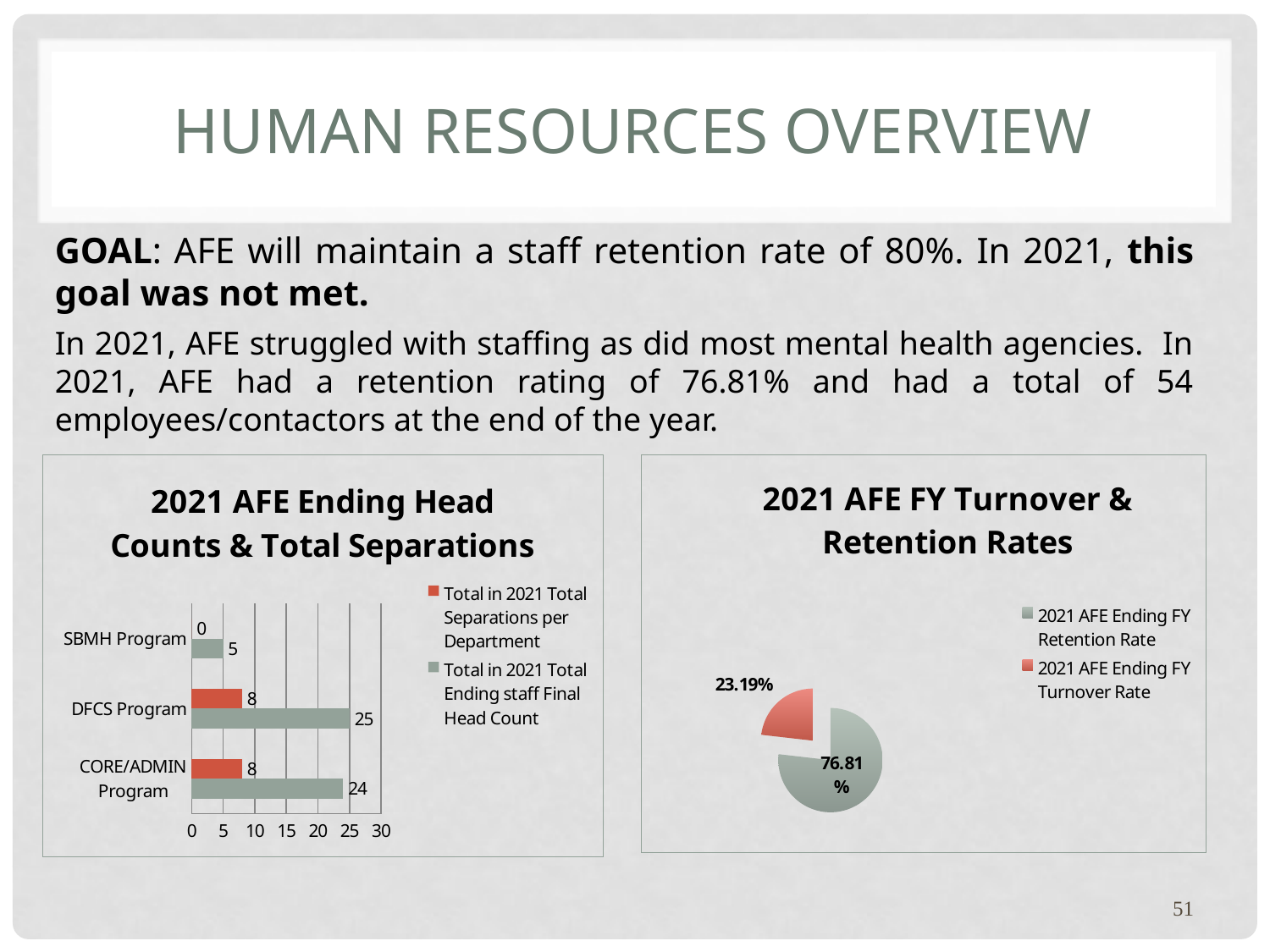
In the '2021 AFE Ending Head Counts & Total Separations' chart, what is the Total in 2021 Total Ending staff Final Head Count for the CORE/ADMIN Program? 24 In the '2021 AFE Ending Head Counts & Total Separations' chart, what is the difference between the ending head count of the DFCS Program and the SBMH Program? 20 In the '2021 AFE Ending Head Counts & Total Separations' chart, what is the Total in 2021 Total Ending staff Final Head Count for the DFCS Program? 25 In the '2021 AFE Ending Head Counts & Total Separations' chart, how many series does the legend list? 2 In the '2021 AFE FY Turnover & Retention Rates' chart, what is the 2021 AFE Ending FY Turnover Rate? 23.19% In the '2021 AFE Ending Head Counts & Total Separations' chart, how many programs are shown? 3 In the '2021 AFE Ending Head Counts & Total Separations' chart, which program has the lowest Total in 2021 Total Ending staff Final Head Count? SBMH Program What kind of chart is the '2021 AFE FY Turnover & Retention Rates' chart? Pie chart What kind of chart is the '2021 AFE Ending Head Counts & Total Separations' chart? Bar chart In the '2021 AFE FY Turnover & Retention Rates' chart, what is the 2021 AFE Ending FY Retention Rate? 76.81% In the '2021 AFE Ending Head Counts & Total Separations' chart, which program has the highest Total in 2021 Total Ending staff Final Head Count? DFCS Program In the '2021 AFE Ending Head Counts & Total Separations' chart, what is the Total in 2021 Total Separations per Department for the SBMH Program? 0